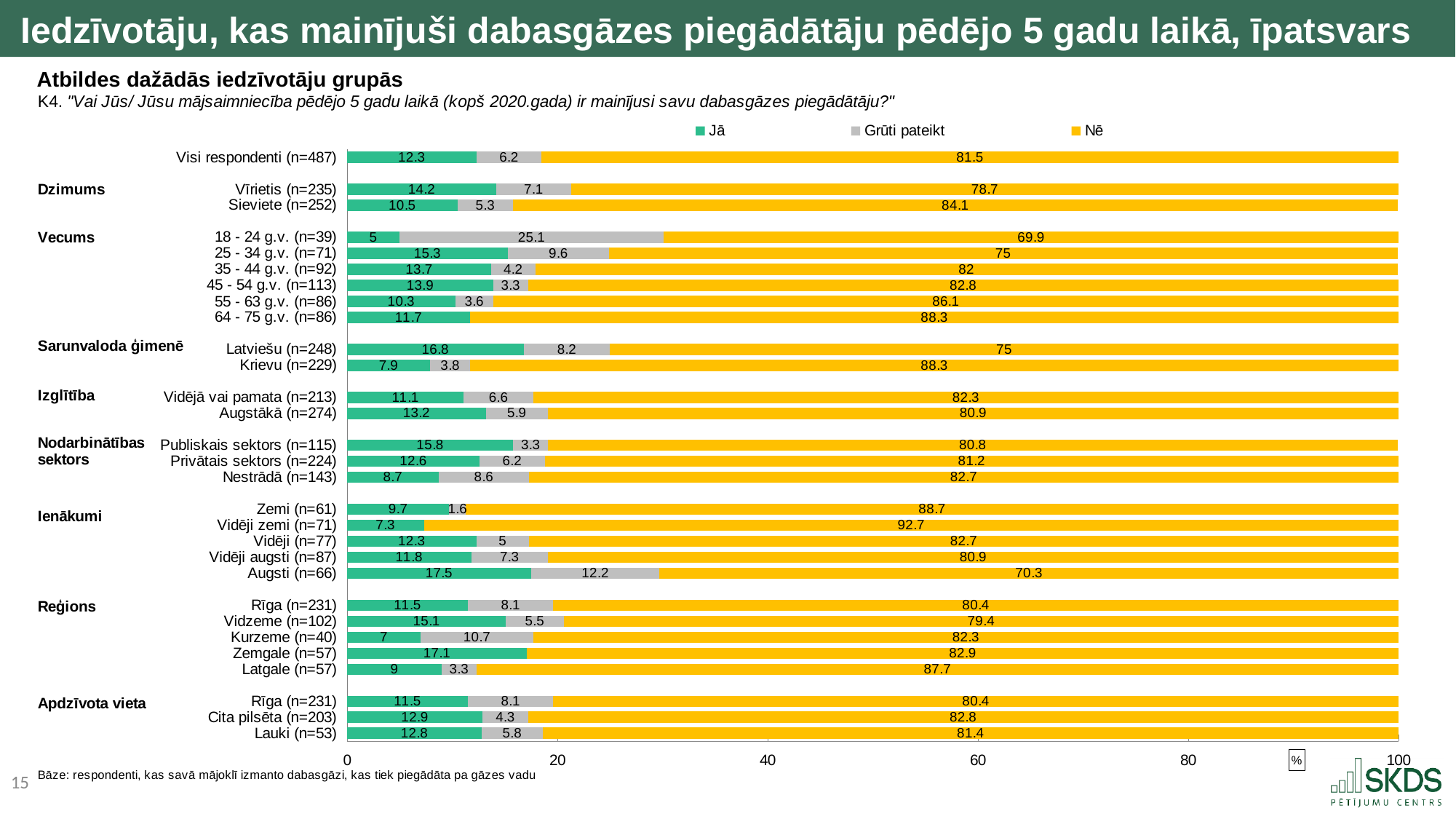
What is the value of the "Grūti pateikt" series for "Kurzeme (n=40)"? 10.7 Which has the larger "Nē" value: "Latviešu (n=248)" or "Krievu (n=229)"? Krievu (n=229) What is the total of the stacked bar for "Visi respondenti (n=487)"? 100 Which category has the highest value for the "Grūti pateikt" series? 18 - 24 g.v. (n=39) What is the value of the "Nē" series for "Vidēji zemi (n=71)"? 92.7 What kind of chart is shown on the slide? Stacked bar chart Is the "Nē" value for "Augsti (n=66)" greater or less than 80? less What is the value of the "Jā" series for "Visi respondenti (n=487)"? 12.3 What is the difference between the "Jā" values for "Vīrietis (n=235)" and "Sieviete (n=252)"? 3.7 What are the three legend entries of the chart? Jā, Grūti pateikt, Nē How many series does the legend list? 3 Which category has the highest value for the "Jā" series? Augsti (n=66)